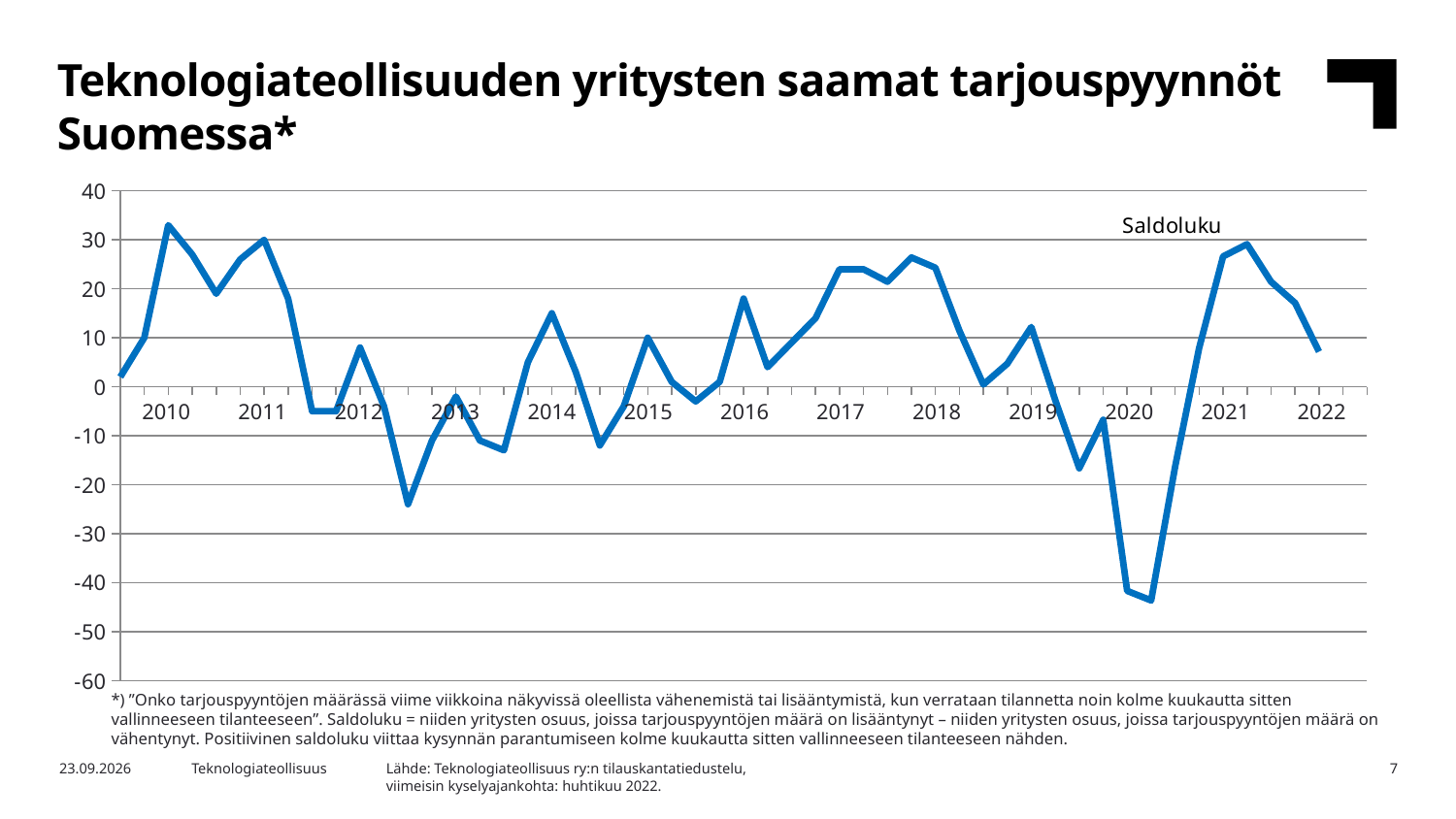
What kind of chart is shown on the slide? line chart Is the highest value of the line in 2010 greater or less than 20? greater How many series does the chart show? 1 What is the name of the series plotted in the chart? Saldoluku Do the values rise or fall from the 2020 low point to the 2021 peak? rise How many year labels are shown on the x axis? 13 What is the title of the chart on the slide? Teknologiateollisuuden yritysten saamat tarjouspyynnöt Suomessa* Is the lowest value of the line in 2020 greater or less than -30? less Is the lowest value of the line around 2012 greater or less than -10? less Do the values rise or fall from the 2021 peak to the end of the line in 2022? fall In which year does the line reach its lowest value? 2020